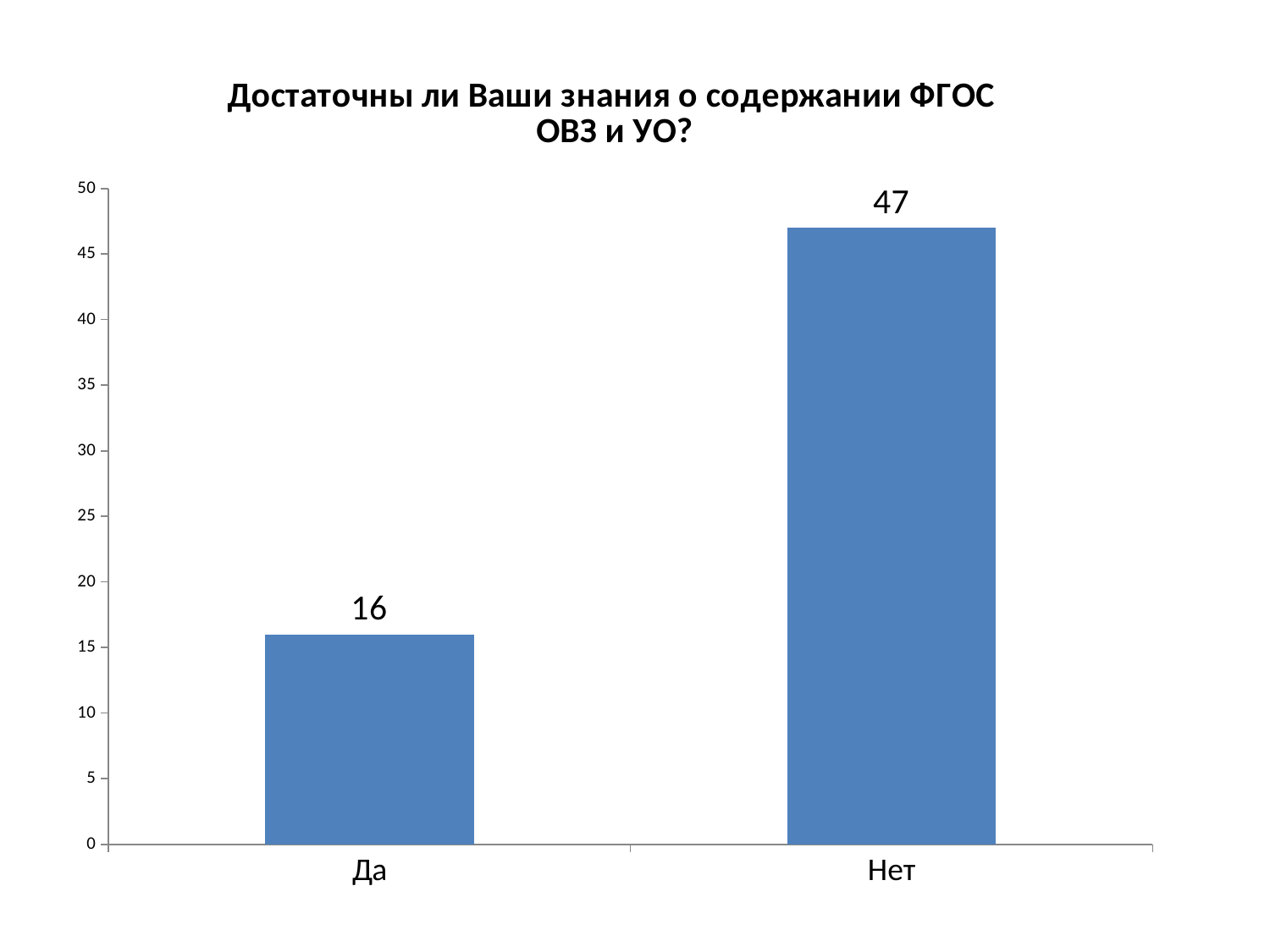
What is the difference between the values for "Нет" and "Да"? 31 Which category has the highest value? Нет Which category has the lowest value? Да What is the value for "Нет"? 47 Which is larger, the value for "Да" or the value for "Нет"? Нет What is the maximum value shown on the vertical axis? 50 What kind of chart is shown on the slide? bar chart How many categories are shown on the chart? 2 What is the title of the chart? Достаточны ли Ваши знания о содержании ФГОС ОВЗ и УО? Is the value for "Да" greater or less than 20? less Is the value for "Нет" greater or less than 45? greater What is the value for "Да"? 16